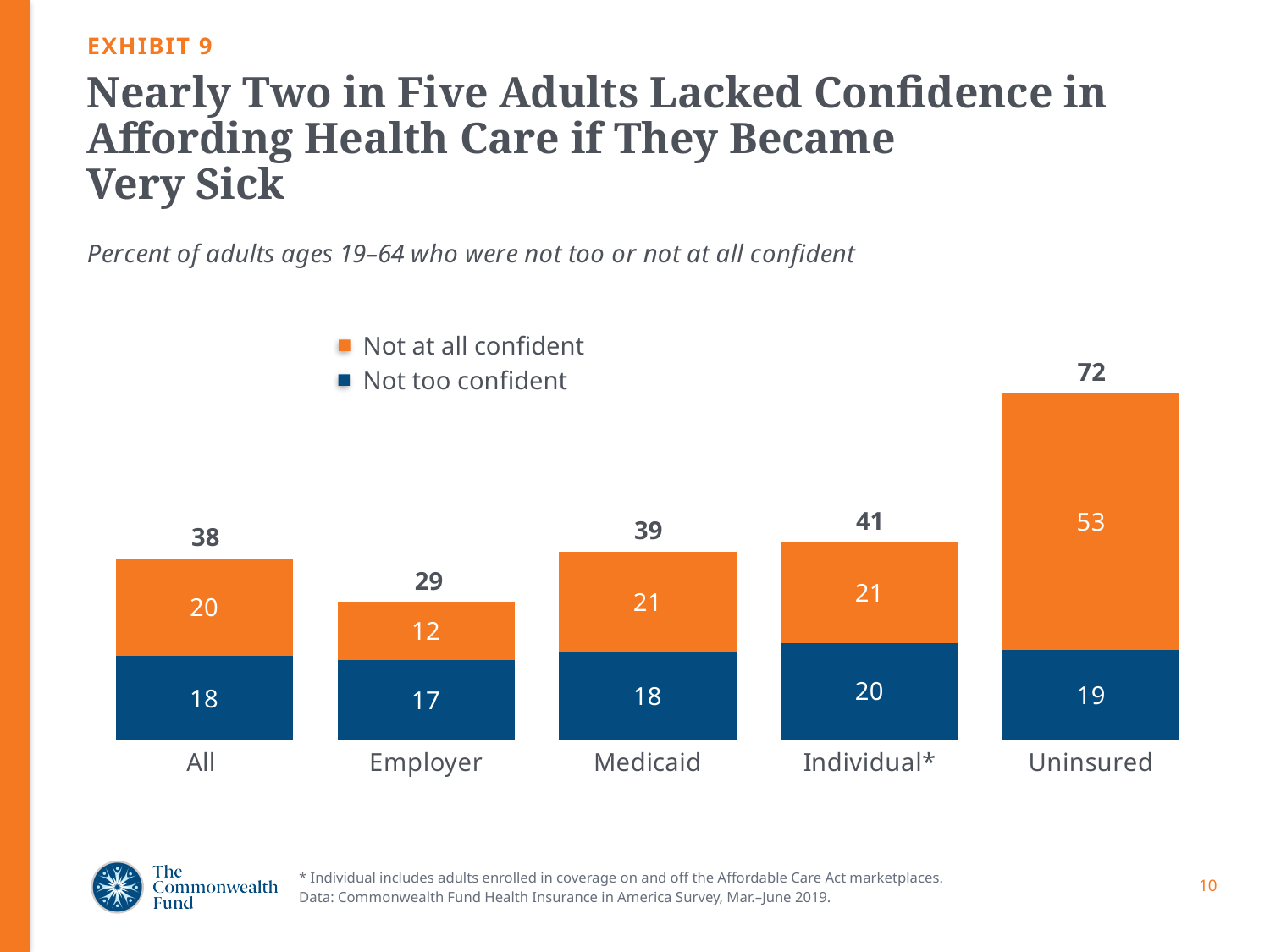
What is the 'Not too confident' value for Employer coverage? 17 How many categories are shown on the x axis? 5 What is the difference between the totals for Uninsured and Employer? 43 Which category has the highest total? Uninsured What is the difference between the 'Not at all confident' and 'Not too confident' values for Uninsured? 34 Which category has the lowest total? Employer Which is larger, the 'Not at all confident' value for Medicaid or for Employer? Medicaid What is the total for the Individual* bar? 41 What is the 'Not at all confident' value for Uninsured adults? 53 What kind of chart is shown? Stacked bar chart Which colour represents 'Not too confident' in the legend? Blue How many series does the legend list? 2